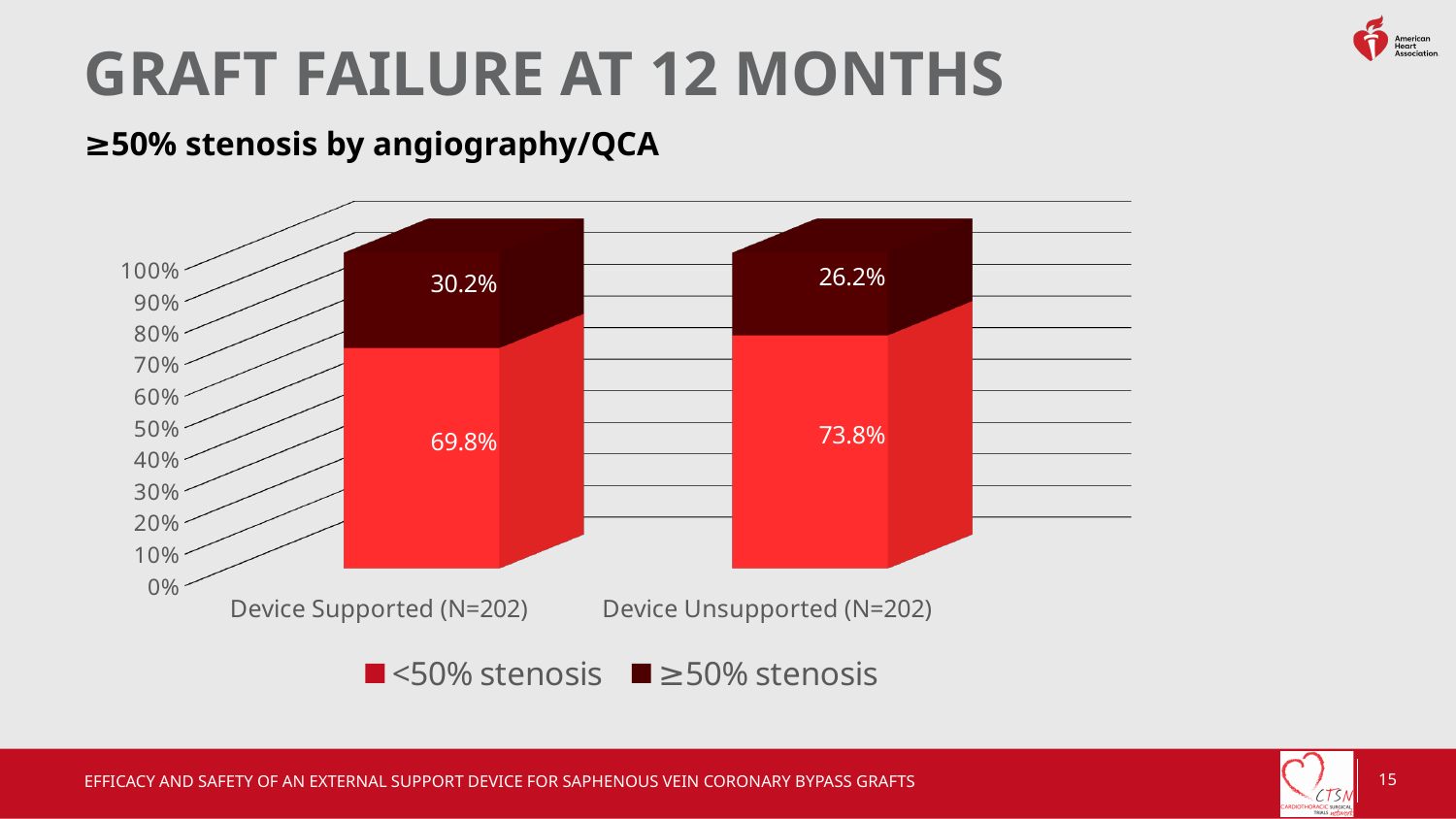
Which group has the higher value for ≥50% stenosis? Device Supported (N=202) What is the value for <50% stenosis in the Device Unsupported (N=202) group? 73.8% What is the difference between the ≥50% stenosis values for Device Supported (N=202) and Device Unsupported (N=202)? 4.0% How many series does the legend list? 2 What is the value for ≥50% stenosis in the Device Supported (N=202) group? 30.2% Which group has the lower value for <50% stenosis? Device Supported (N=202) Is the <50% stenosis value larger for Device Supported (N=202) or Device Unsupported (N=202)? Device Unsupported (N=202) What is the value for ≥50% stenosis in the Device Unsupported (N=202) group? 26.2% What is the value for <50% stenosis in the Device Supported (N=202) group? 69.8% What is the total of the stacked bar for Device Unsupported (N=202)? 100.0% What kind of chart is shown on the slide? Stacked bar chart How many categories are shown on the x axis? 2